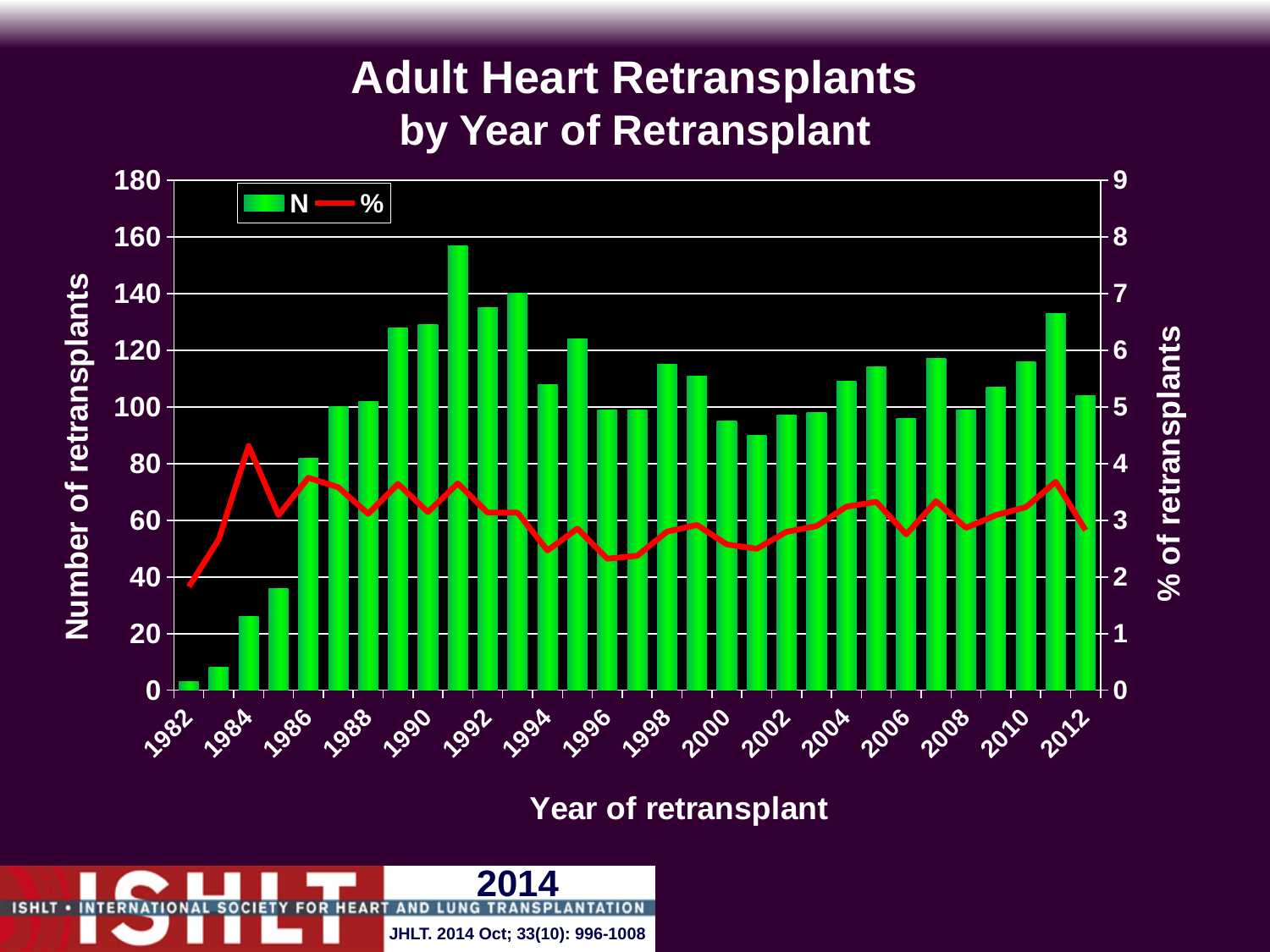
Which year has more retransplants, 1991 or 2011? 1991 Is the number of retransplants in 1984 greater or less than 40? less Which year has the highest number of retransplants (tallest bar)? 1991 What are the two series named in the legend? N and % Is the percentage of retransplants in 2001 greater or less than 3? less What is the title of the chart? Adult Heart Retransplants by Year of Retransplant How many series does the legend list? 2 What kind of chart is shown on the slide? A bar chart combined with a line chart Which year has the lowest number of retransplants (shortest bar)? 1982 Is the number of retransplants in 2001 greater or less than 100? less Do the number of retransplants rise or fall from 1982 to 1991? rise